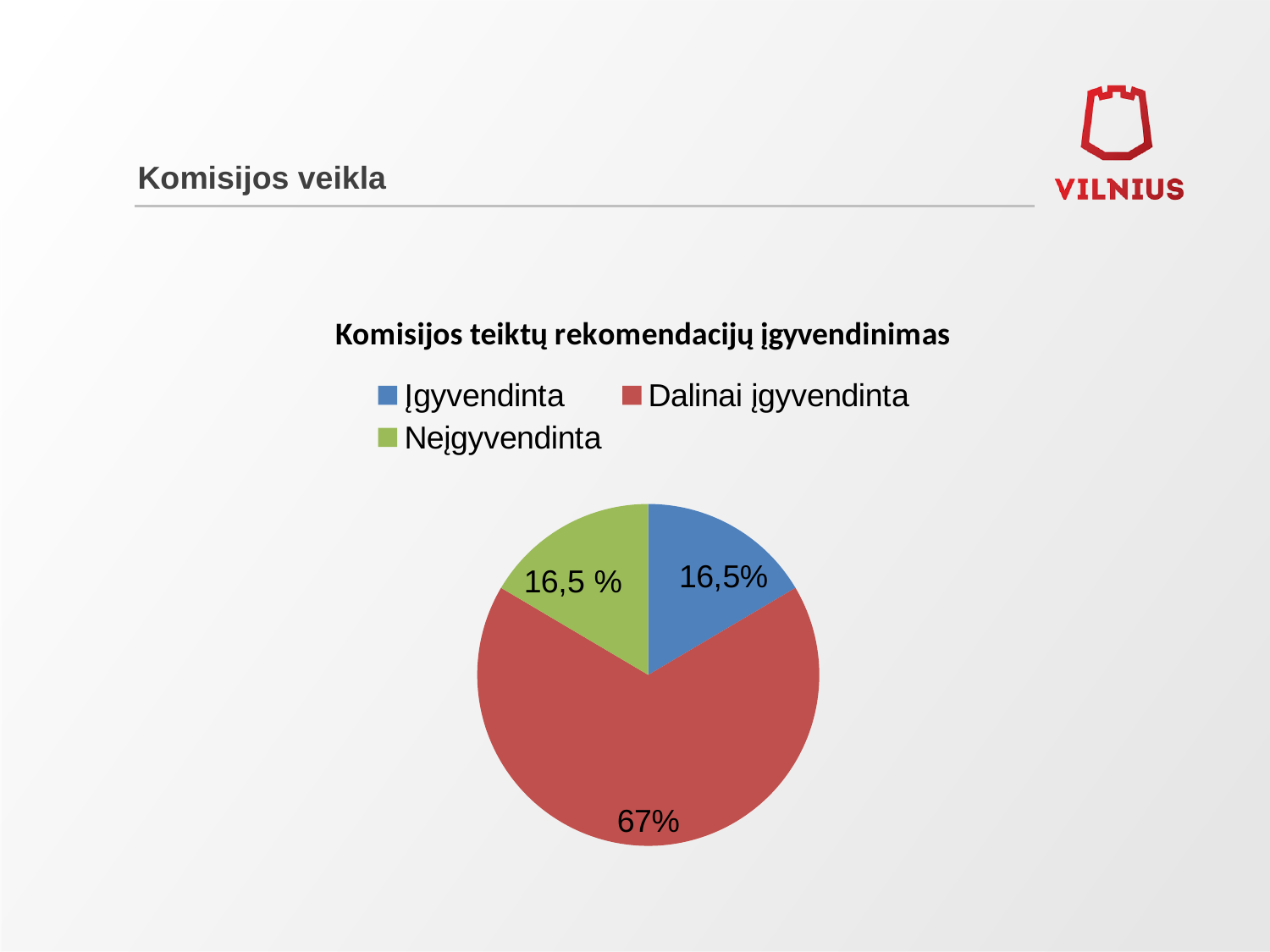
Which category has the largest slice of the pie? Dalinai įgyvendinta Which colour represents Neįgyvendinta in the pie chart? Green Which is larger, the Dalinai įgyvendinta slice or the Įgyvendinta slice? Dalinai įgyvendinta How many entries does the legend list? 3 What share of the pie does the Dalinai įgyvendinta slice represent? 67% What kind of chart is shown on the slide? Pie chart What value is shown for the Neįgyvendinta slice? 16,5 % Is the share for Dalinai įgyvendinta greater or less than 50%? greater What value is shown for the Įgyvendinta slice? 16,5% How many slices does the pie chart have? 3 What is the title of the chart? Komisijos teiktų rekomendacijų įgyvendinimas By how many percentage points does Dalinai įgyvendinta exceed Įgyvendinta? 50,5